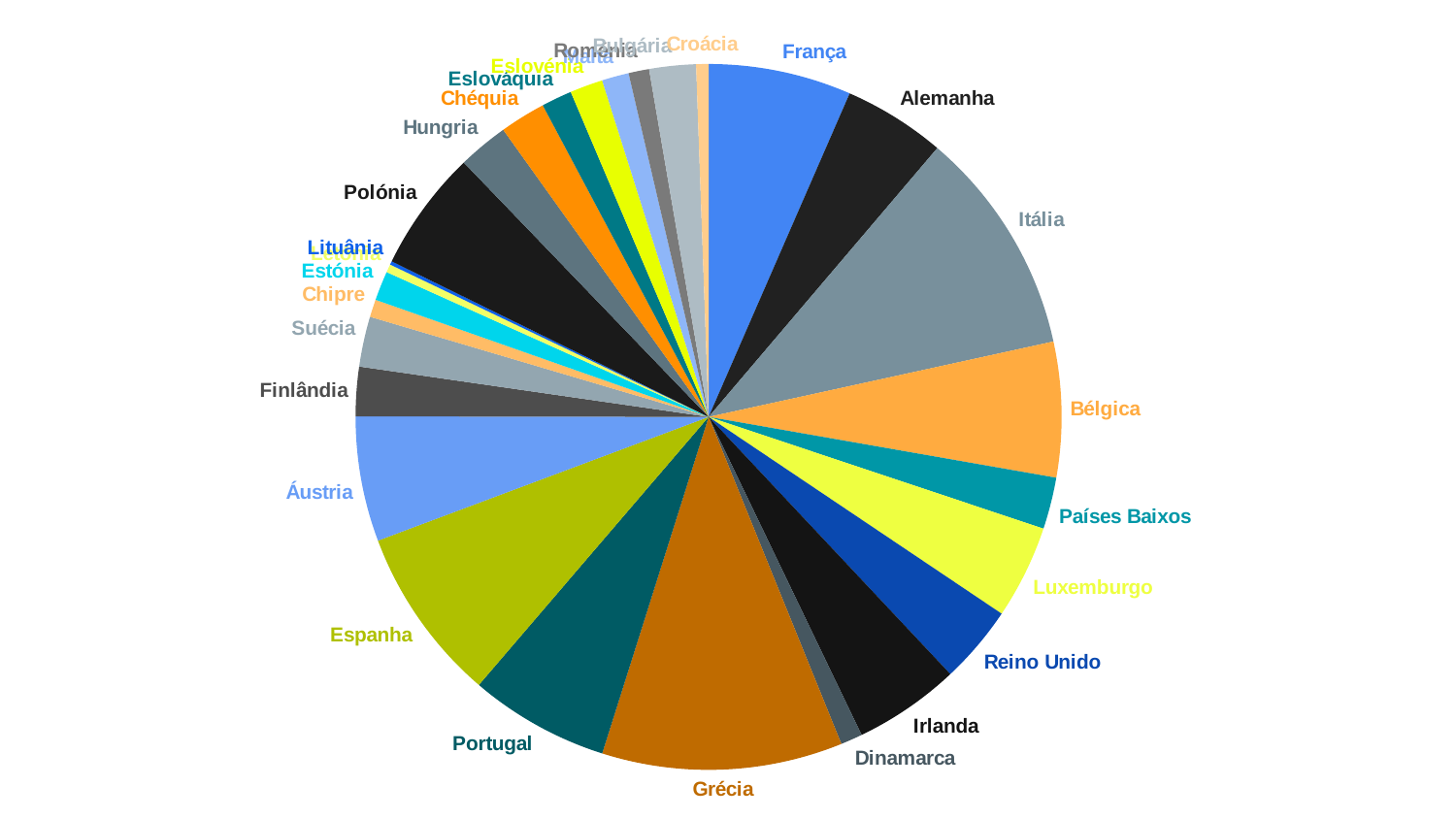
Which slice is larger, Itália or Finlândia? Itália Which slice is larger, Reino Unido or Lituânia? Reino Unido What colour is the Espanha slice? yellow-green Which slice is larger, Bélgica or Chipre? Bélgica What colour is the Bélgica slice? orange What kind of chart is shown on the slide? pie chart